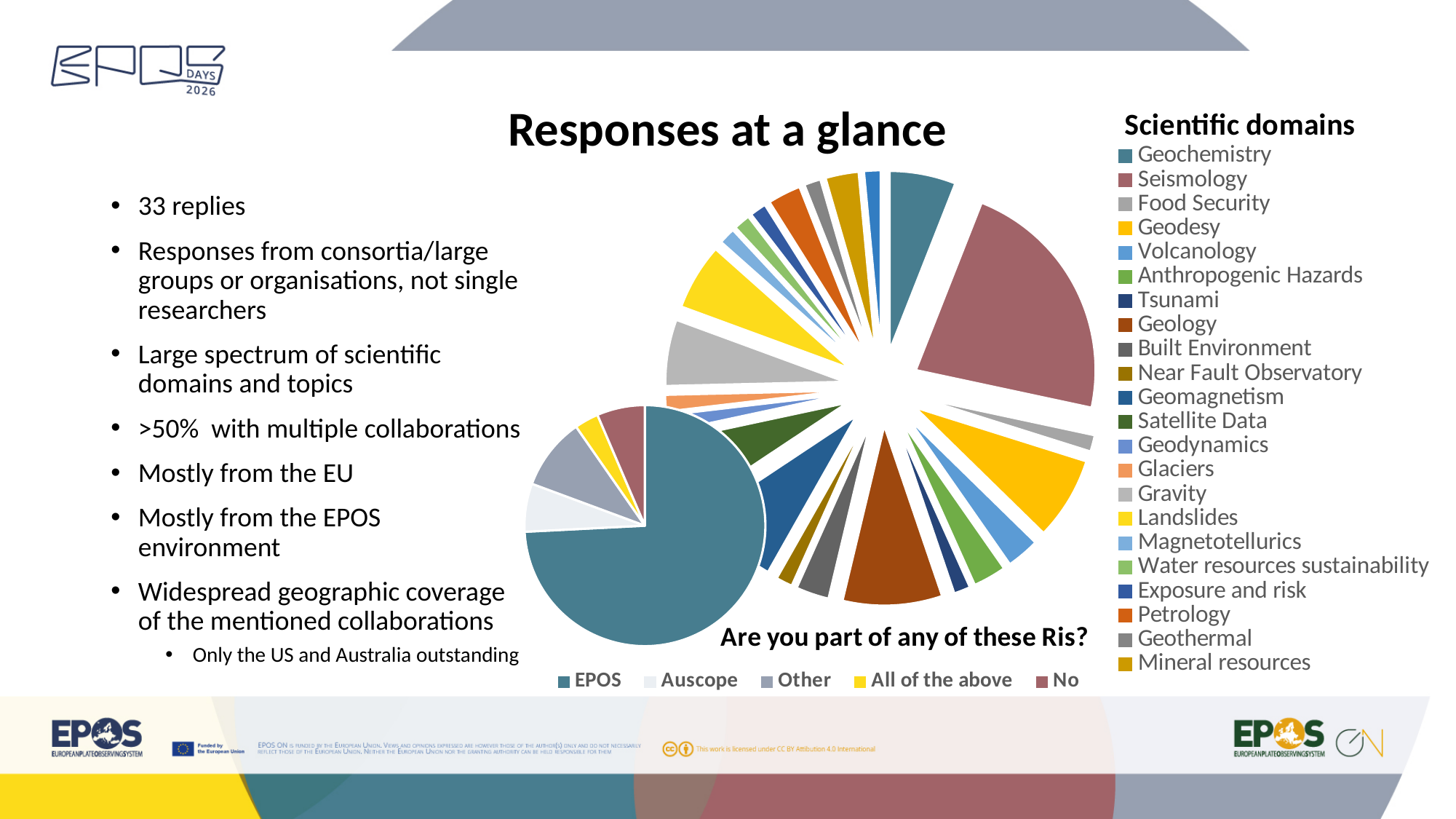
What is the first entry in the legend of the "Scientific domains" chart? Geochemistry What is the last entry in the legend of the "Scientific domains" chart? Mineral resources In the "Scientific domains" chart, which slice is larger, Seismology or Geochemistry? Seismology In the "Scientific domains" chart, which slice is larger, Seismology or Geodesy? Seismology What kind of chart is the "Are you part of any of these Ris?" chart? pie chart In the "Are you part of any of these Ris?" chart, which slice is larger, EPOS or Auscope? EPOS How many categories does the legend of the "Scientific domains" chart list? 22 What kind of chart is the "Scientific domains" chart? pie chart In the "Are you part of any of these Ris?" chart, which category has the largest slice? EPOS In the "Scientific domains" chart, which category has the largest slice? Seismology How many categories does the legend of the "Are you part of any of these Ris?" chart list? 5